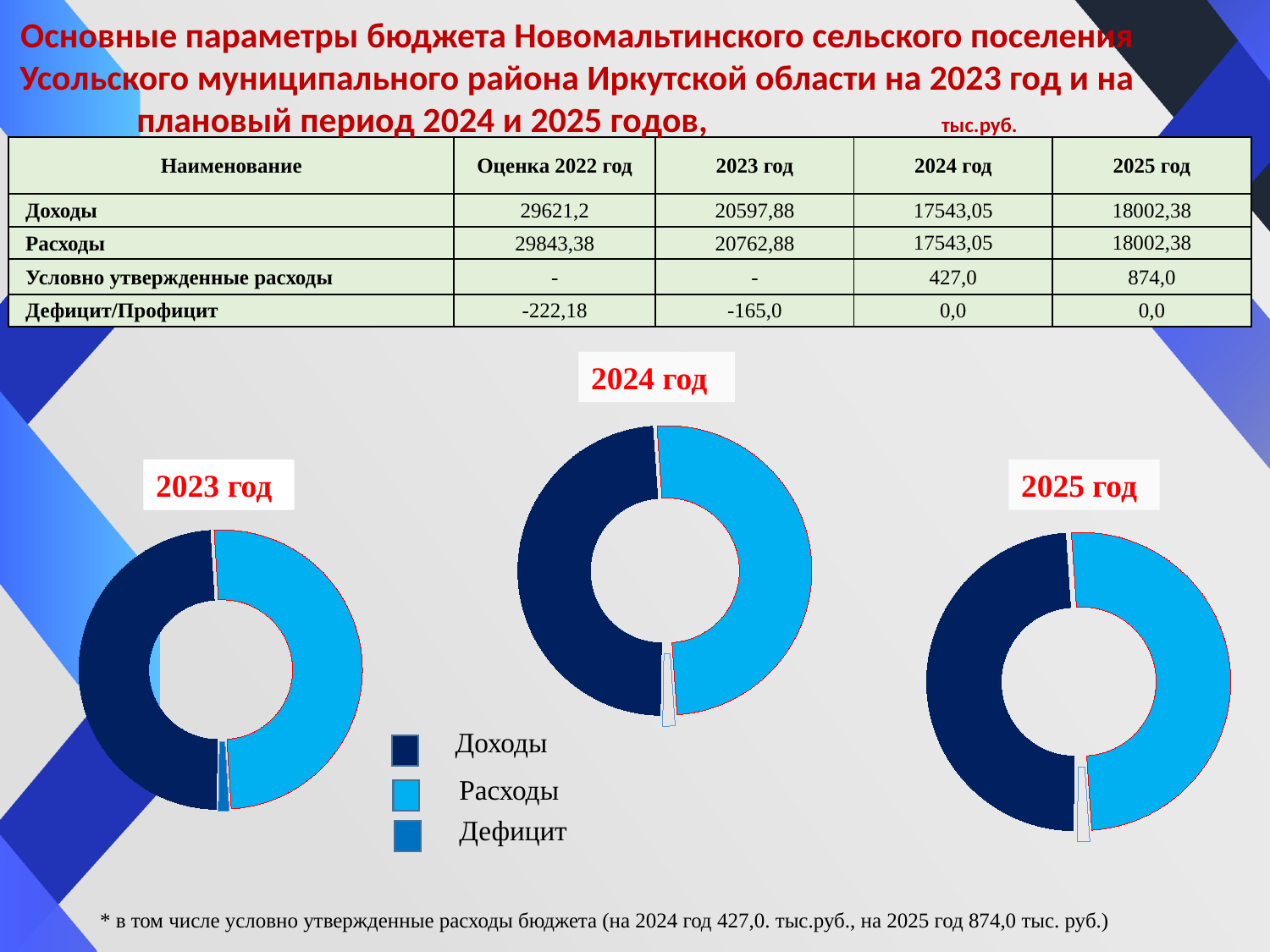
How many slices does the 2023 год doughnut chart have? 3 In the 2025 год chart, which category has the smallest slice? Дефицит What kind of chart is used for the 2023 год, 2024 год and 2025 год charts? doughnut (pie) chart What are the legend entries for the doughnut charts? Доходы, Расходы, Дефицит Which colour represents Доходы in the doughnut charts? dark navy blue In the 2023 год chart, which slice is larger: Доходы or Дефицит? Доходы In the 2024 год chart, which slice is larger: Расходы or Дефицит? Расходы In the 2023 год chart, which category has the smallest slice? Дефицит How many doughnut charts are shown on the slide? 3 How many series does the shared legend list for the doughnut charts? 3 In the 2024 год chart, which category has the smallest slice? Дефицит